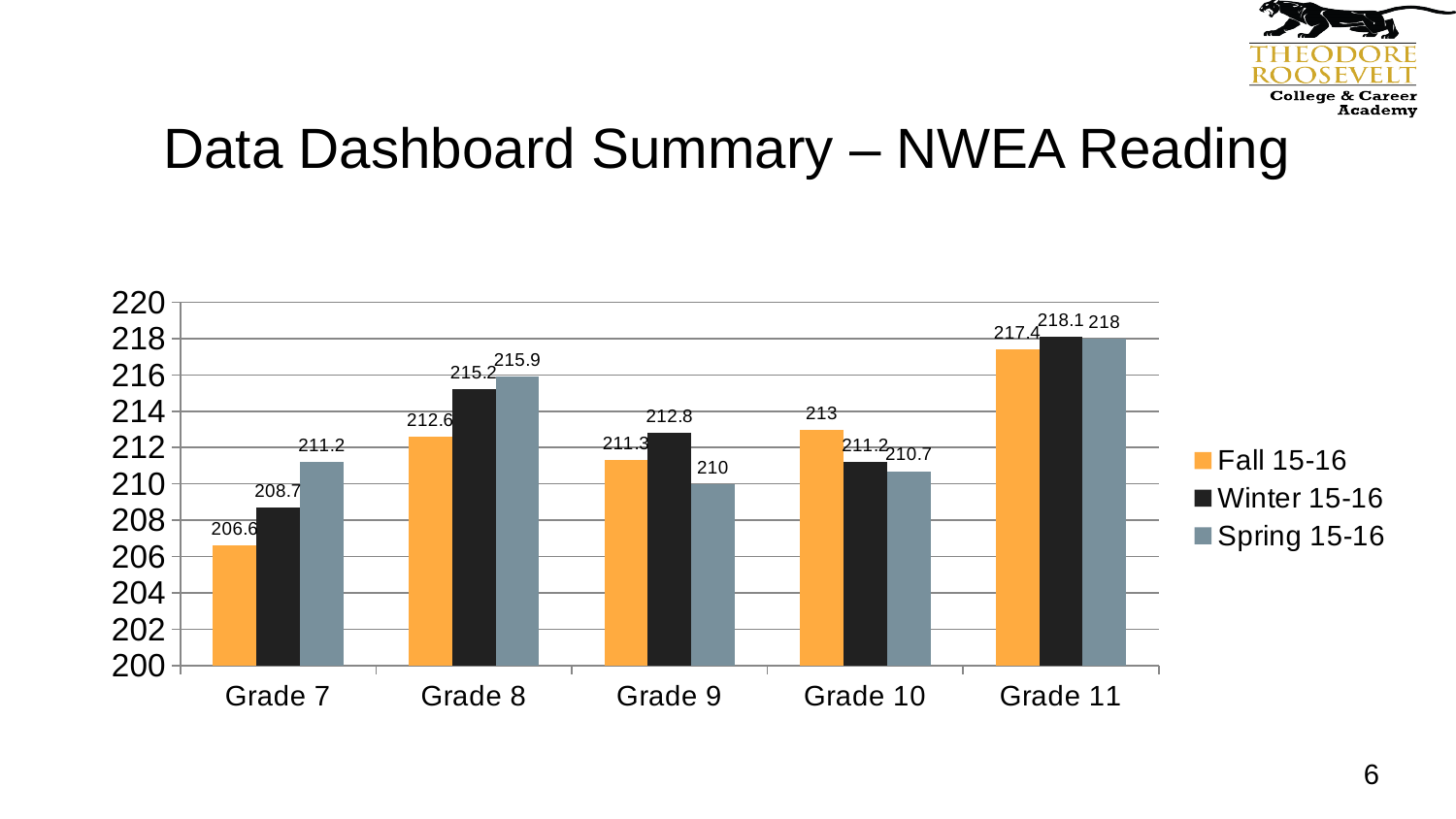
What is the Winter 15-16 value for Grade 9? 212.8 How many series does the legend list? 3 Which grade has the lowest Spring 15-16 value? Grade 9 What is the Spring 15-16 value for Grade 8? 215.9 What is the Fall 15-16 value for Grade 7? 206.6 What is the difference between the Spring 15-16 and Fall 15-16 values for Grade 7? 4.6 Which grade has the highest Fall 15-16 value? Grade 11 How many grade categories are shown on the x axis? 5 Which is larger for Grade 10: the Fall 15-16 value or the Winter 15-16 value? Fall 15-16 Do the Fall 15-16 values rise or fall from Grade 9 to Grade 11? Rise Is the Winter 15-16 value for Grade 8 greater or less than 214? greater What kind of chart is shown on the slide? Bar chart